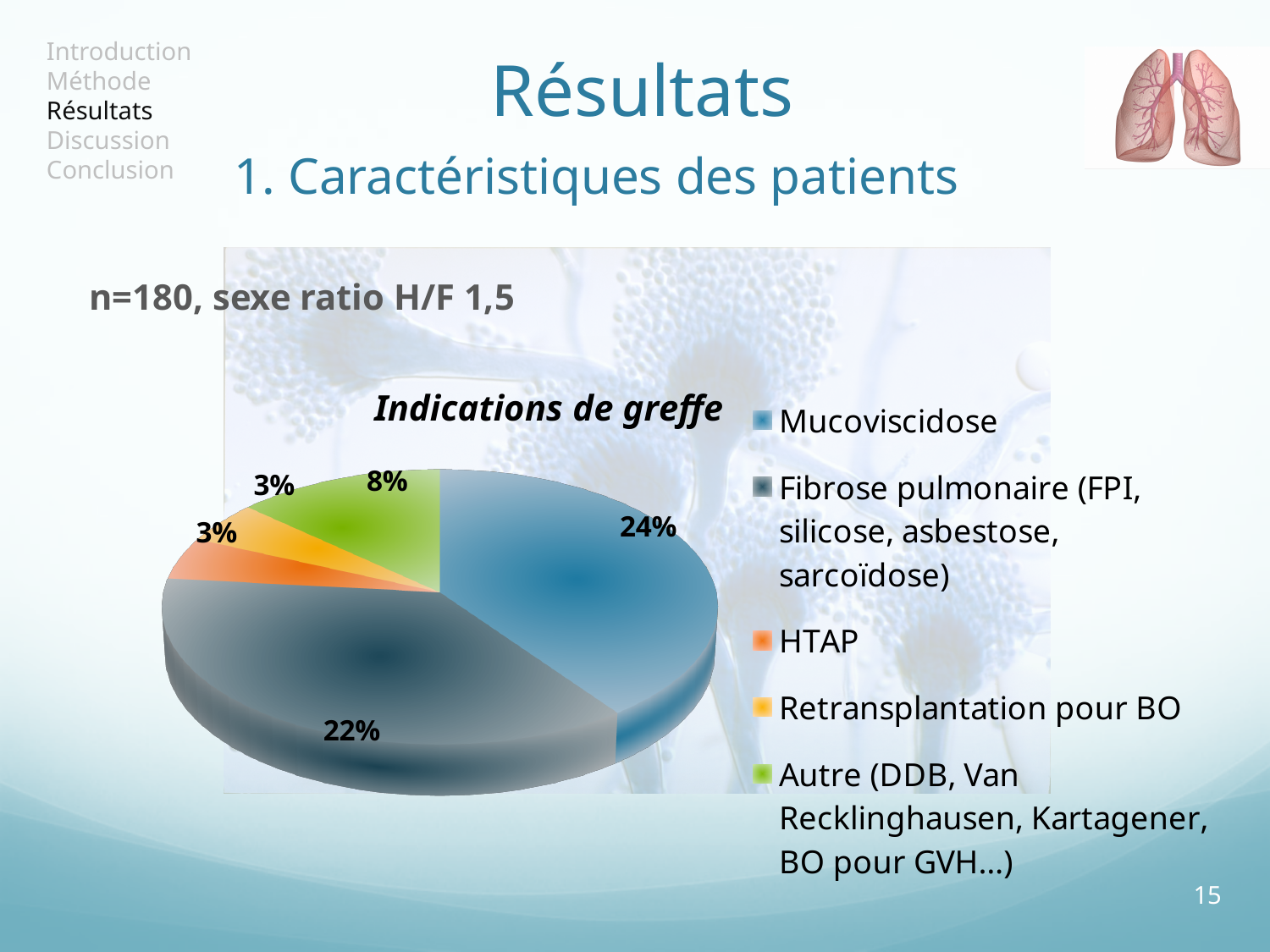
What is the title of the pie chart? Indications de greffe What percentage is shown for Fibrose pulmonaire (FPI, silicose, asbestose, sarcoïdose)? 22% What colour is the slice for Autre in the pie chart? Green What is the difference in percentage points between Mucoviscidose and Fibrose pulmonaire? 2 Which has the larger share, Autre or HTAP? Autre How many entries does the legend of the pie chart list? 5 How many slices does the pie chart have? 5 What percentage is shown for Mucoviscidose in the pie chart? 24% Which indication has the largest share in the pie chart? Mucoviscidose What kind of chart is shown on the slide? Pie chart What percentage is shown for Autre (DDB, Van Recklinghausen, Kartagener, BO pour GVH…)? 8% What percentage is shown for HTAP in the pie chart? 3%